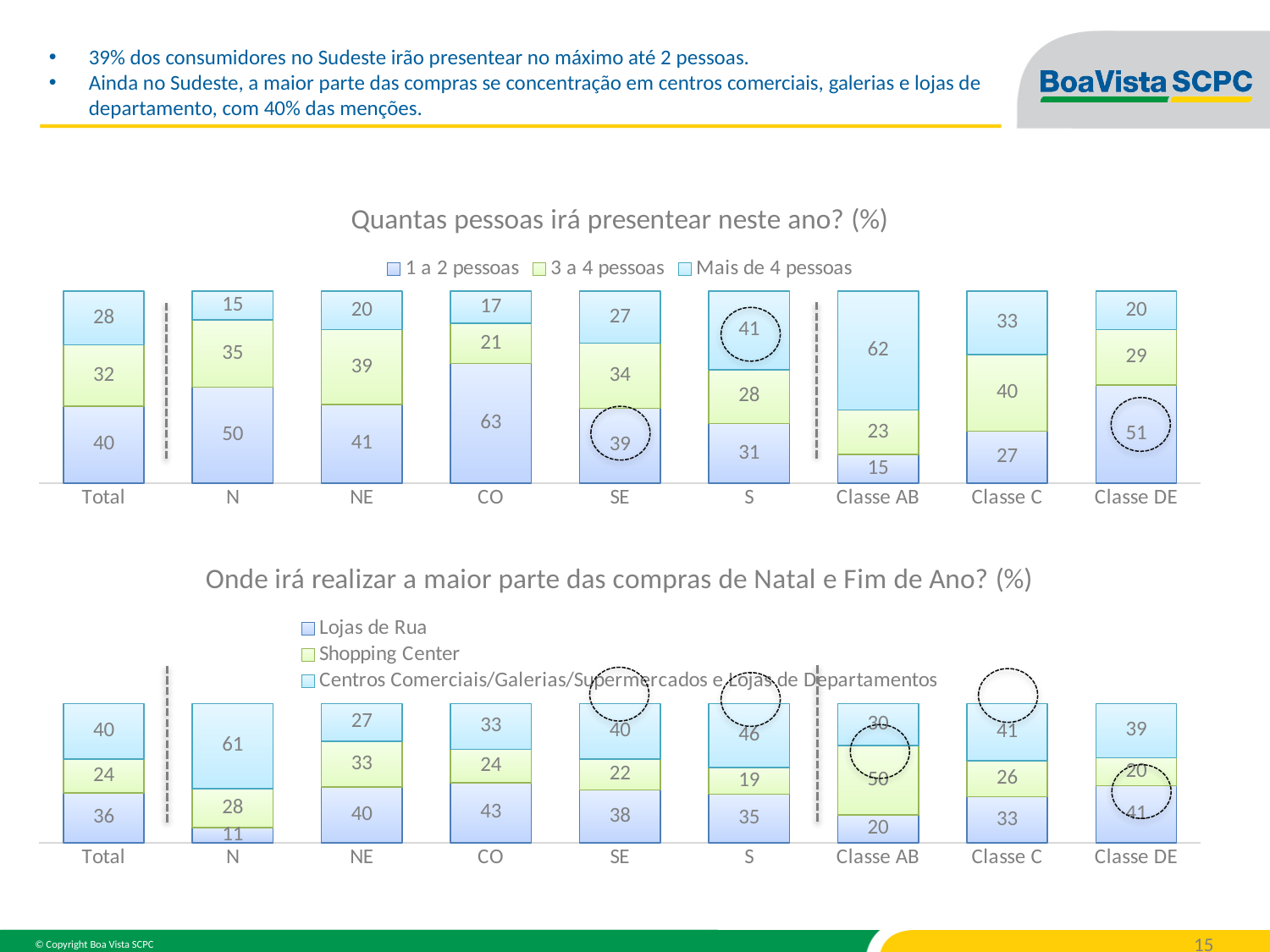
In the chart 'Quantas pessoas irá presentear neste ano? (%)', what is the value for 'Mais de 4 pessoas' in Classe AB? 62 In the chart 'Onde irá realizar a maior parte das compras de Natal e Fim de Ano? (%)', is the 'Lojas de Rua' value larger for NE or for S? NE In the chart 'Quantas pessoas irá presentear neste ano? (%)', how many series does the legend list? 3 What type of chart is 'Onde irá realizar a maior parte das compras de Natal e Fim de Ano? (%)'? Stacked bar chart In the chart 'Onde irá realizar a maior parte das compras de Natal e Fim de Ano? (%)', what is the value for 'Lojas de Rua' in the N category? 11 In the chart 'Quantas pessoas irá presentear neste ano? (%)', which category has the lowest value for '1 a 2 pessoas'? Classe AB In the chart 'Onde irá realizar a maior parte das compras de Natal e Fim de Ano? (%)', what is the value for 'Centros Comerciais/Galerias/Supermercados e Lojas de Departamentos' in the SE category? 40 In the chart 'Quantas pessoas irá presentear neste ano? (%)', which category has the highest value for '1 a 2 pessoas'? CO In the chart 'Onde irá realizar a maior parte das compras de Natal e Fim de Ano? (%)', which category has the highest value for 'Centros Comerciais/Galerias/Supermercados e Lojas de Departamentos'? N In the chart 'Onde irá realizar a maior parte das compras de Natal e Fim de Ano? (%)', how many categories are shown on the x axis? 9 In the chart 'Quantas pessoas irá presentear neste ano? (%)', what is the value for '1 a 2 pessoas' in the SE category? 39 In the chart 'Quantas pessoas irá presentear neste ano? (%)', what is the difference between the '3 a 4 pessoas' values for Classe C and Classe DE? 11